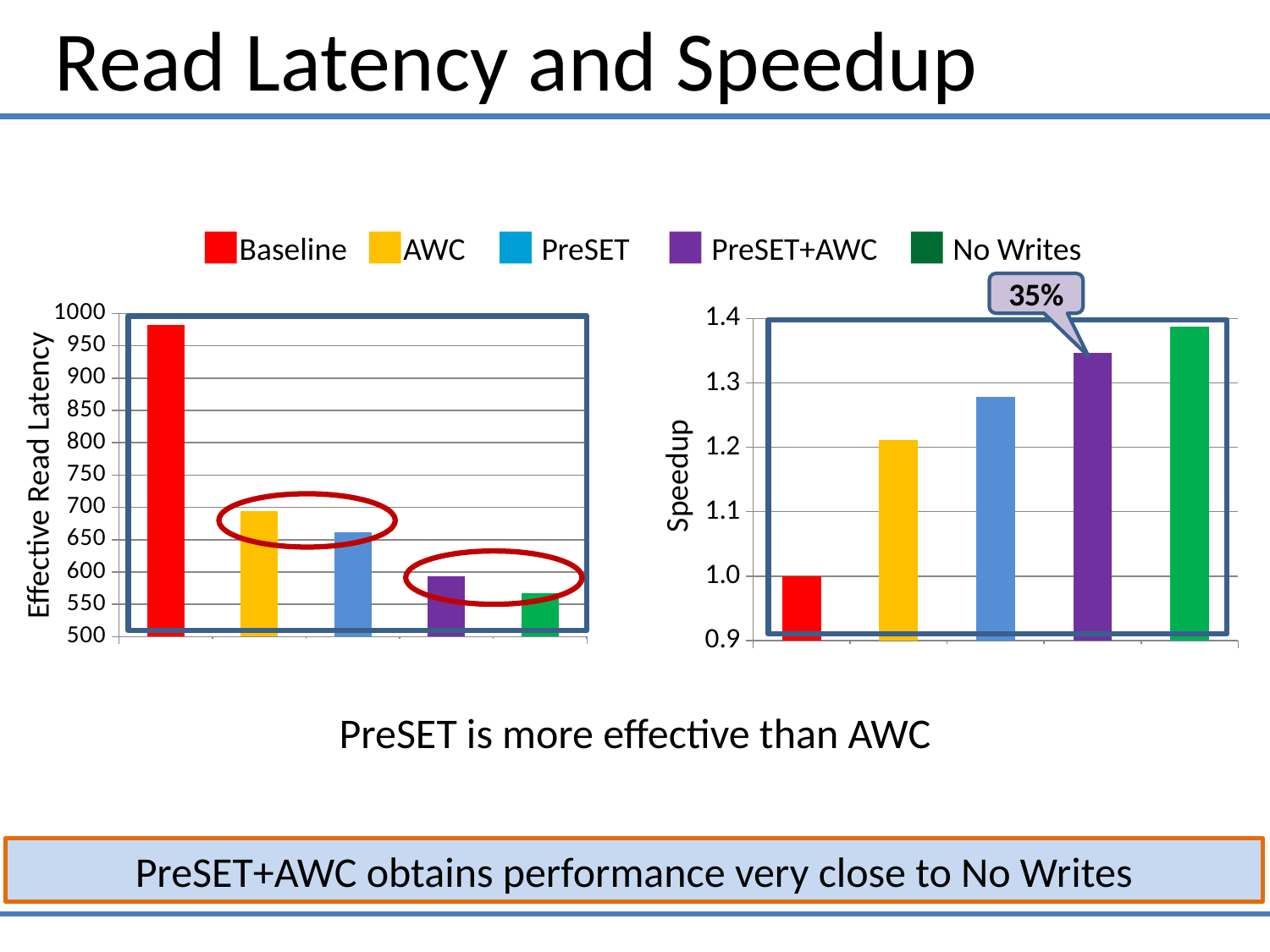
On the Speedup chart, which category has the highest speedup? No Writes On the Effective Read Latency chart, which has the higher latency, AWC or PreSET? AWC On the Speedup chart, is the value for AWC greater or less than 1.1? greater How many series does the legend list? 5 On the Speedup chart, what is the speedup value for Baseline? 1.0 On the Effective Read Latency chart, is the value for No Writes greater or less than 600? less On the Effective Read Latency chart, which category has the lowest latency? No Writes On the Speedup chart, what percentage is shown in the callout pointing to the PreSET+AWC bar? 35% On the Effective Read Latency chart, is the value for Baseline greater or less than 950? greater On the Speedup chart, which has the higher speedup, AWC or PreSET? PreSET On the Effective Read Latency chart, which category has the highest latency? Baseline